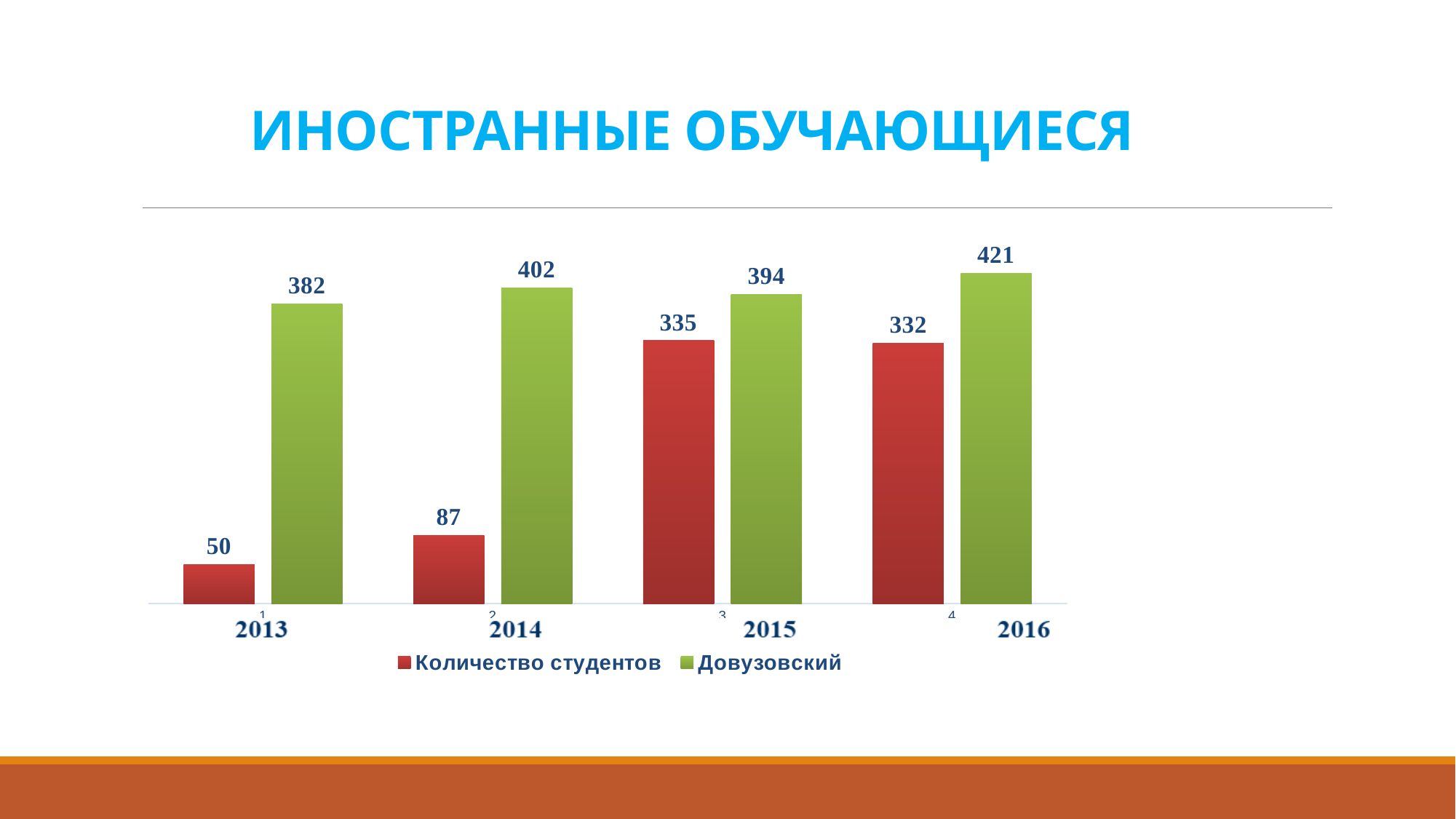
What is the difference between Довузовский and Количество студентов in 2014? 315 Does Количество студентов rise or fall from 2013 to 2015? Rise In which year is Количество студентов lowest? 2013 What kind of chart is shown on the slide? Bar chart How many years are shown on the x axis? 4 What is the value for Количество студентов in 2015? 335 What is the value for Количество студентов in 2013? 50 What is the value for Довузовский in 2016? 421 How many series does the legend list? 2 In which year is Довузовский highest? 2016 Which is larger in 2016: Количество студентов or Довузовский? Довузовский What is the title of the slide? ИНОСТРАННЫЕ ОБУЧАЮЩИЕСЯ